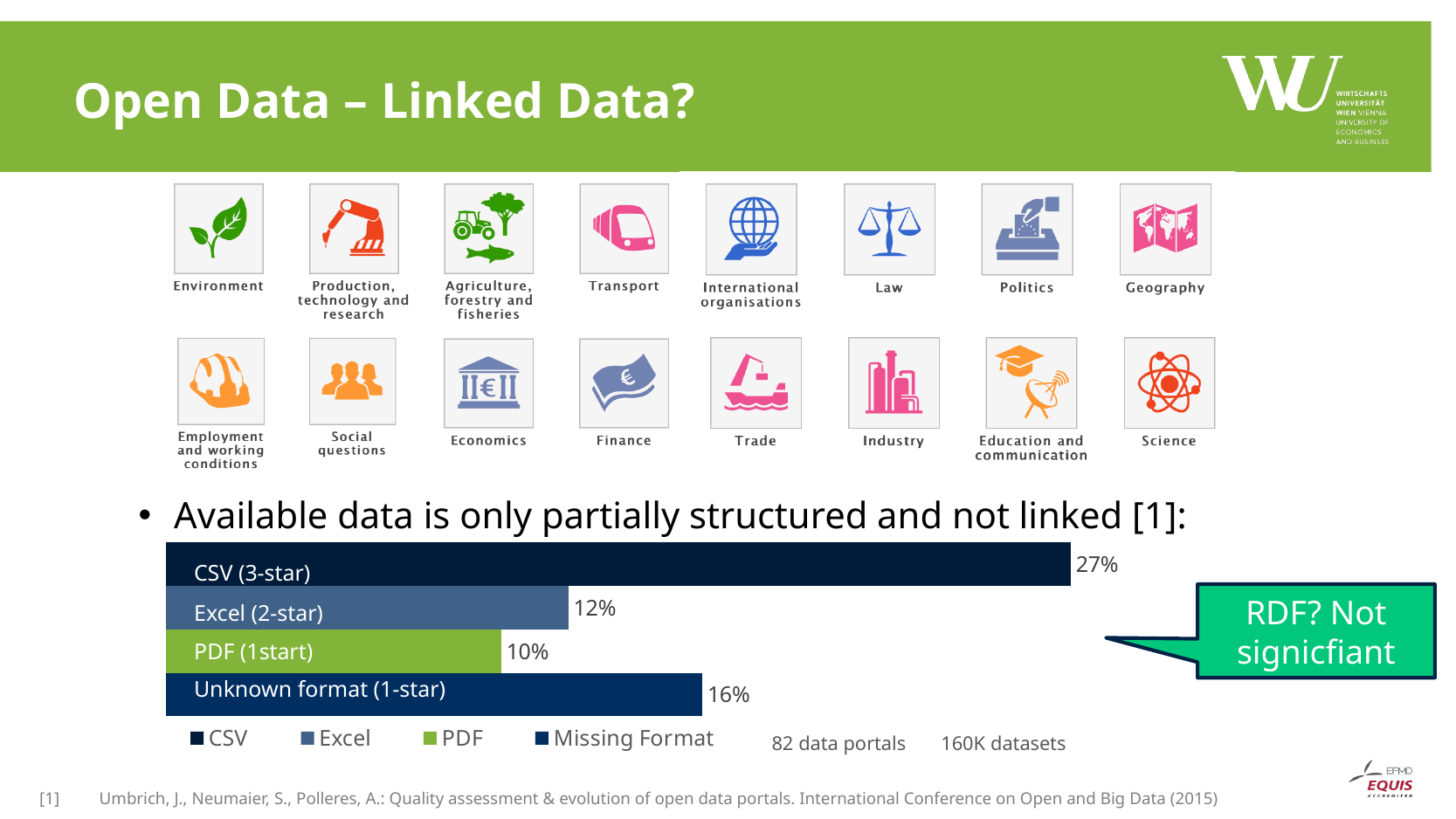
How many entries does the chart legend list? 4 What type of chart is shown on the slide? Bar chart Which has a larger percentage, Excel (2-star) or Unknown format (1-star)? Unknown format (1-star) What percentage is shown for Unknown format (1-star)? 16% What label does the legend use for the bar labelled Unknown format (1-star)? Missing Format Which format has the lowest percentage in the bar chart? PDF (1start) What percentage is shown for CSV (3-star)? 27% Which format has the highest percentage in the bar chart? CSV (3-star) What is the difference in percentage points between CSV (3-star) and Excel (2-star)? 15 What is the difference in percentage points between Unknown format (1-star) and PDF (1start)? 6 What percentage is shown for Excel (2-star)? 12% How many bars are shown in the chart? 4